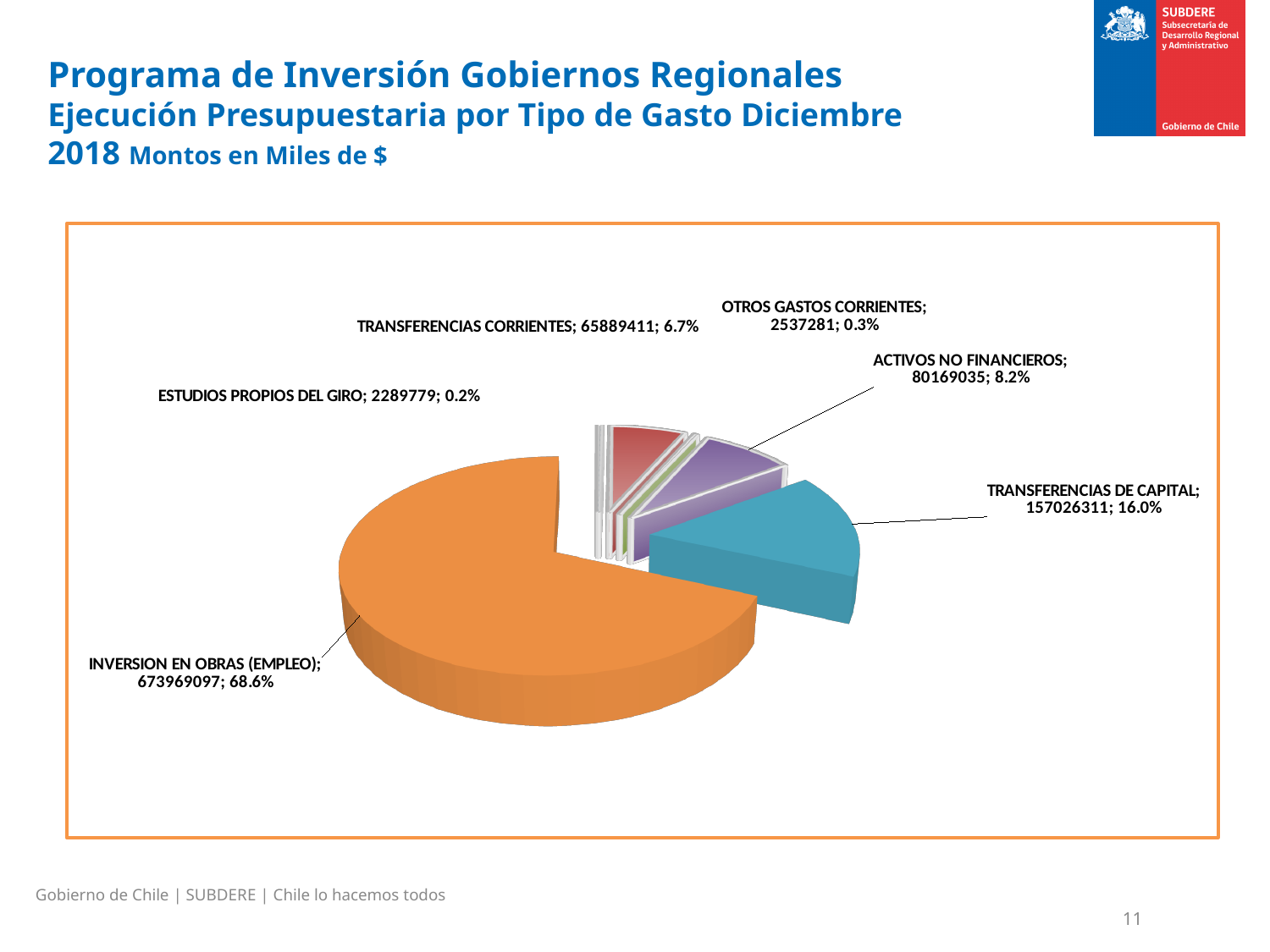
How many categories (slices) does the pie chart show? 6 What is the value for OTROS GASTOS CORRIENTES? 2537281 What share of the pie does ESTUDIOS PROPIOS DEL GIRO represent? 0.2% Which is larger, the value for ACTIVOS NO FINANCIEROS or the value for TRANSFERENCIAS CORRIENTES? ACTIVOS NO FINANCIEROS What is the value for INVERSION EN OBRAS (EMPLEO)? 673969097 What is the value for ACTIVOS NO FINANCIEROS? 80169035 What is the difference between the values for TRANSFERENCIAS DE CAPITAL and ACTIVOS NO FINANCIEROS? 76857276 Which category has the smallest slice of the pie? ESTUDIOS PROPIOS DEL GIRO What is the value for TRANSFERENCIAS DE CAPITAL? 157026311 What kind of chart is shown on the slide? Pie chart What share of the pie does TRANSFERENCIAS CORRIENTES represent? 6.7% Which category has the largest slice of the pie? INVERSION EN OBRAS (EMPLEO)